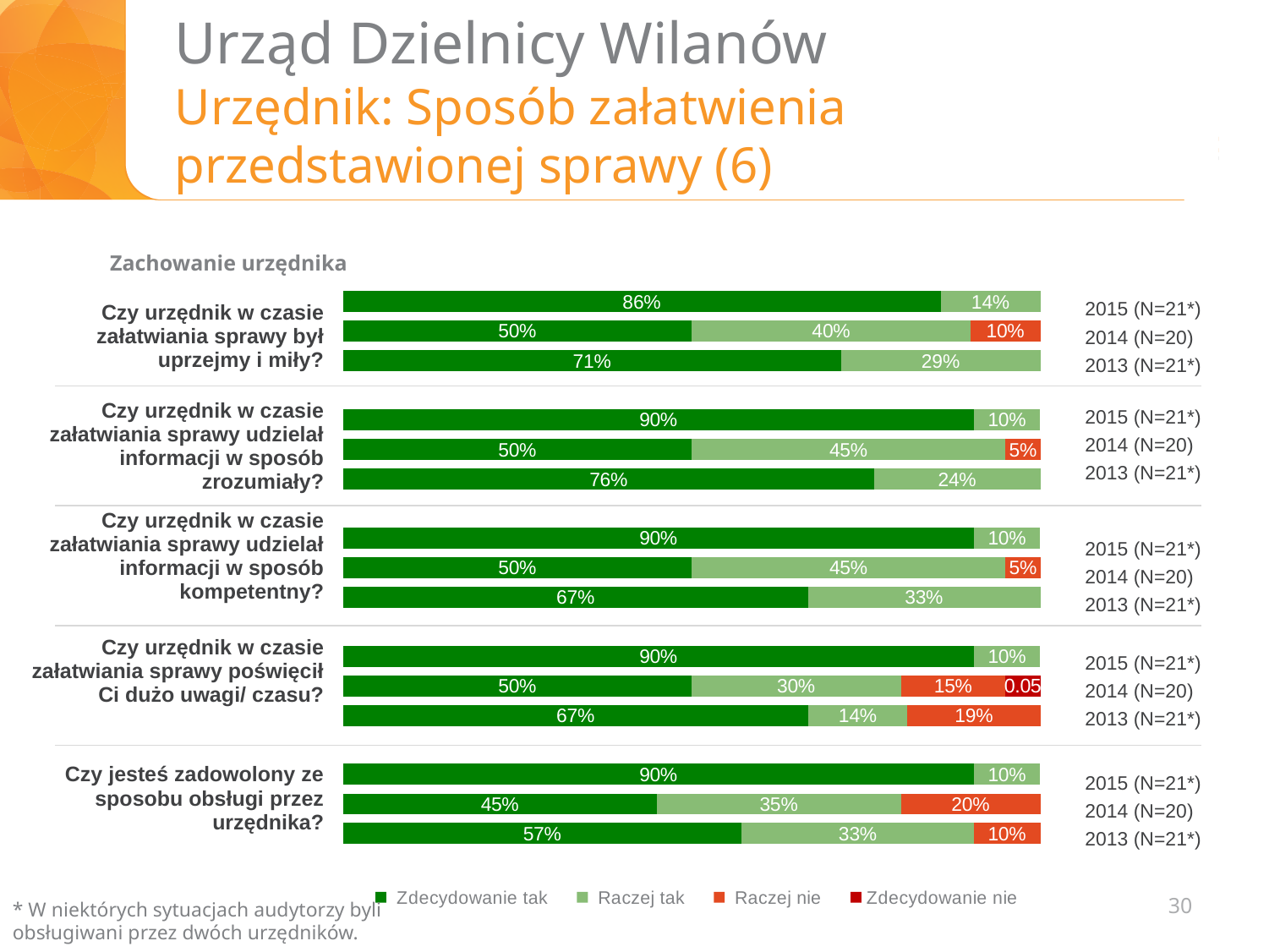
What percentage answered "Zdecydowanie tak" in 2015 to "Czy urzędnik w czasie załatwiania sprawy był uprzejmy i miły?"? 86% For "Czy jesteś zadowolony ze sposobu obsługi przez urzędnika?", which year has the lowest "Zdecydowanie tak" share? 2014 What colour represents "Zdecydowanie tak" in the legend? Dark green How many series does the legend list? 4 What percentage answered "Raczej tak" in 2014 to "Czy urzędnik w czasie załatwiania sprawy był uprzejmy i miły?"? 40% For "Czy urzędnik w czasie załatwiania sprawy poświęcił Ci dużo uwagi/ czasu?", which year has the highest "Zdecydowanie tak" share? 2015 What kind of chart is shown on the slide? Stacked bar chart In 2013, which question had a larger "Zdecydowanie tak" share: "udzielał informacji w sposób zrozumiały" or "udzielał informacji w sposób kompetentny"? udzielał informacji w sposób zrozumiały What percentage answered "Raczej nie" in 2013 to "Czy urzędnik w czasie załatwiania sprawy poświęcił Ci dużo uwagi/ czasu?"? 19% For "Czy urzędnik w czasie załatwiania sprawy był uprzejmy i miły?", what is the difference between the "Zdecydowanie tak" share in 2015 and in 2014? 36 percentage points How many years are shown for each question in the chart? 3 What percentage answered "Raczej nie" in 2014 to "Czy jesteś zadowolony ze sposobu obsługi przez urzędnika?"? 20%